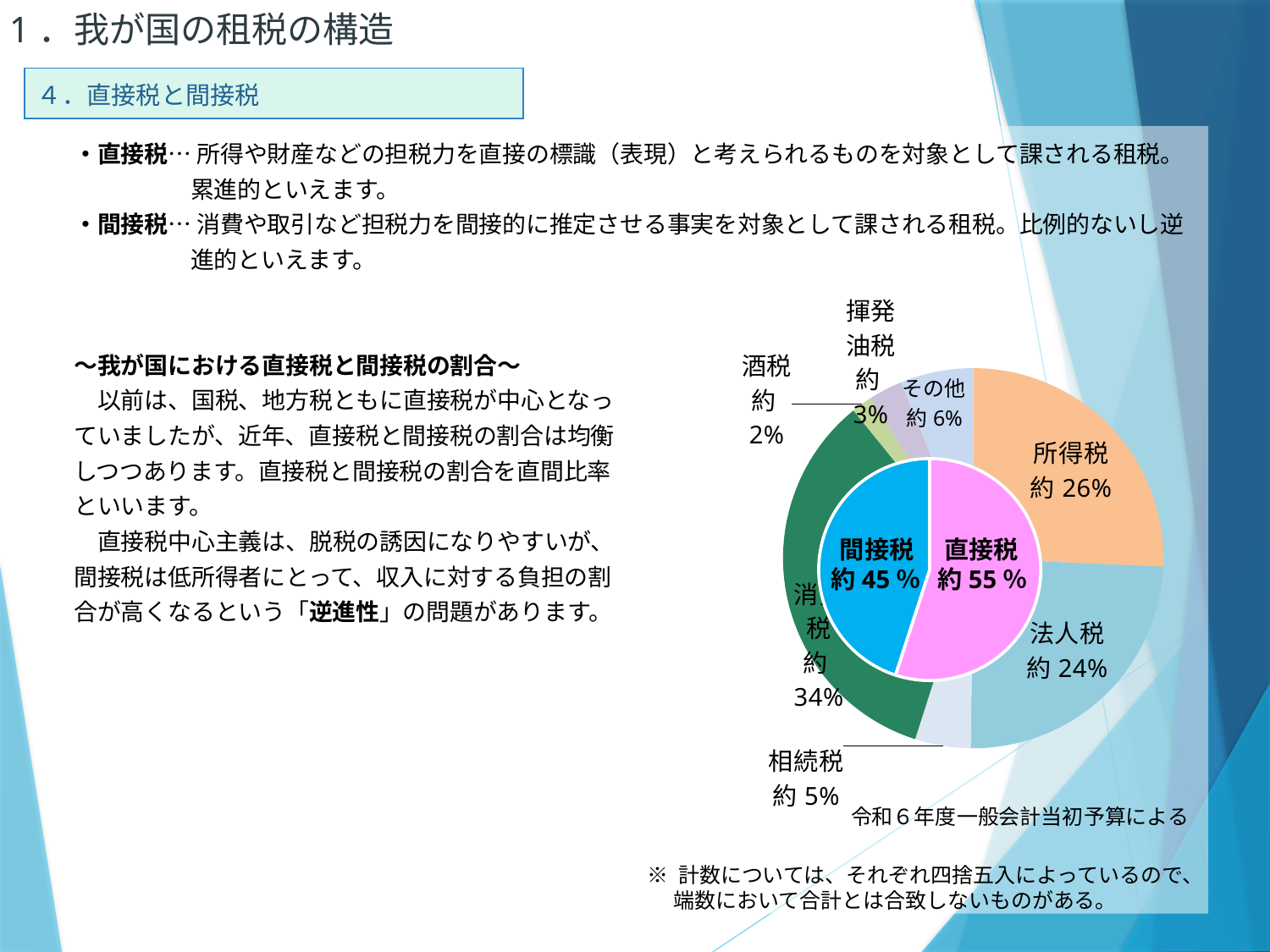
グラフで所得税の割合はいくらですか？ 約 26% グラフの外側の税目のうち、割合が最も小さいのはどれですか？ 酒税 グラフで法人税の割合はいくらですか？ 約 24% グラフの外側の税目のうち、割合が最も大きいのはどれですか？ 消費税 このグラフはどの種類のグラフですか？ 円グラフ グラフの外側の輪には税目がいくつ示されていますか？ 7 グラフで間接税全体の割合はいくらですか？ 約 45％ グラフで直接税全体の割合はいくらですか？ 約 55％ グラフで所得税と法人税の割合の差は何ポイントですか？ 2ポイント グラフで相続税の割合はいくらですか？ 約 5% グラフで所得税と法人税では、どちらの割合が大きいですか？ 所得税 グラフで消費税の割合はいくらですか？ 約 34%